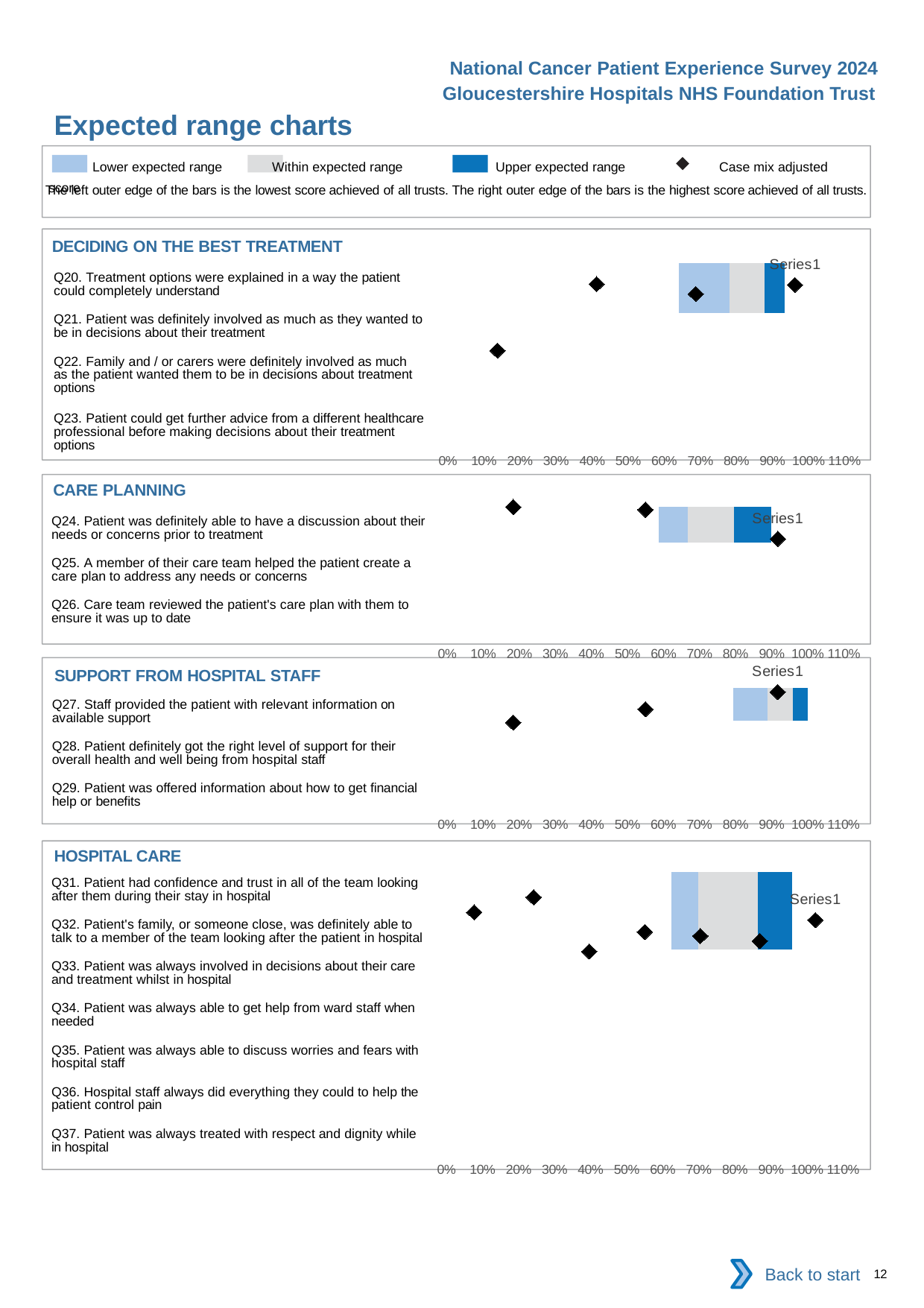
According to the legend at the top of the slide, which colour represents the upper expected range? dark blue How many questions (categories) are listed in the 'DECIDING ON THE BEST TREATMENT' chart? 4 How many questions (categories) are listed in the 'HOSPITAL CARE' chart? 7 In the 'DECIDING ON THE BEST TREATMENT' chart, is the highest case mix adjusted score marker greater or less than 80%? greater How many questions (categories) are listed in the 'CARE PLANNING' chart? 3 In the 'HOSPITAL CARE' chart, is the lowest case mix adjusted score marker greater or less than 20%? less In the 'SUPPORT FROM HOSPITAL STAFF' chart, is the highest case mix adjusted score marker greater or less than 80%? greater What kind of chart is used in the 'DECIDING ON THE BEST TREATMENT' section? bar chart What is the highest value shown on the x axis of the 'HOSPITAL CARE' chart? 110%